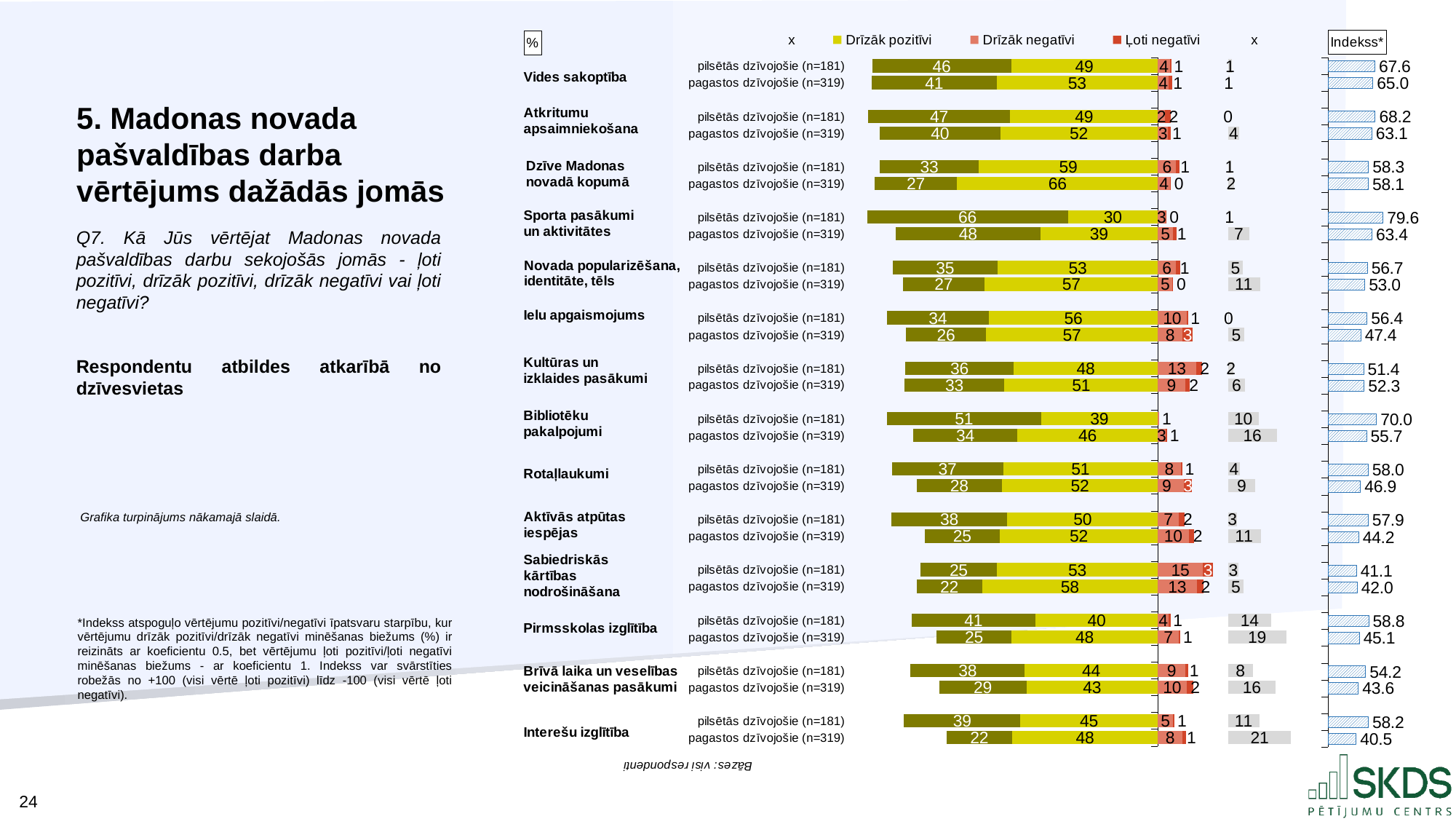
What is the 'Drīzāk pozitīvi' value for 'Dzīve Madonas novadā kopumā' among pagastos dzīvojošie (n=319)? 66 Which row has the highest Indekss* value on the slide? Sporta pasākumi un aktivitātes, pilsētās dzīvojošie (79.6) What is the difference between the Indekss* values for pilsētās dzīvojošie and pagastos dzīvojošie for 'Sporta pasākumi un aktivitātes'? 16.2 How many areas (row groups) are evaluated in the chart on this slide? 14 Which row has the lowest Indekss* value on the slide? Interešu izglītība, pagastos dzīvojošie (40.5) What is the Indekss* value for 'Bibliotēku pakalpojumi' among pilsētās dzīvojošie (n=181)? 70.0 What kind of chart is shown on the slide? Stacked horizontal bar chart What is the title of the slide? 5. Madonas novada pašvaldības darba vērtējums dažādās jomās What is the 'Drīzāk negatīvi' value for 'Sabiedriskās kārtības nodrošināšana' among pilsētās dzīvojošie (n=181)? 15 How many series are named in the chart legend? 3 Which is larger: the 'Drīzāk negatīvi' value for 'Sabiedriskās kārtības nodrošināšana' (pilsētās) or for 'Kultūras un izklaides pasākumi' (pilsētās)? Sabiedriskās kārtības nodrošināšana (15) What is the combined 'Drīzāk negatīvi' and 'Ļoti negatīvi' value for 'Sabiedriskās kārtības nodrošināšana' among pilsētās dzīvojošie? 18